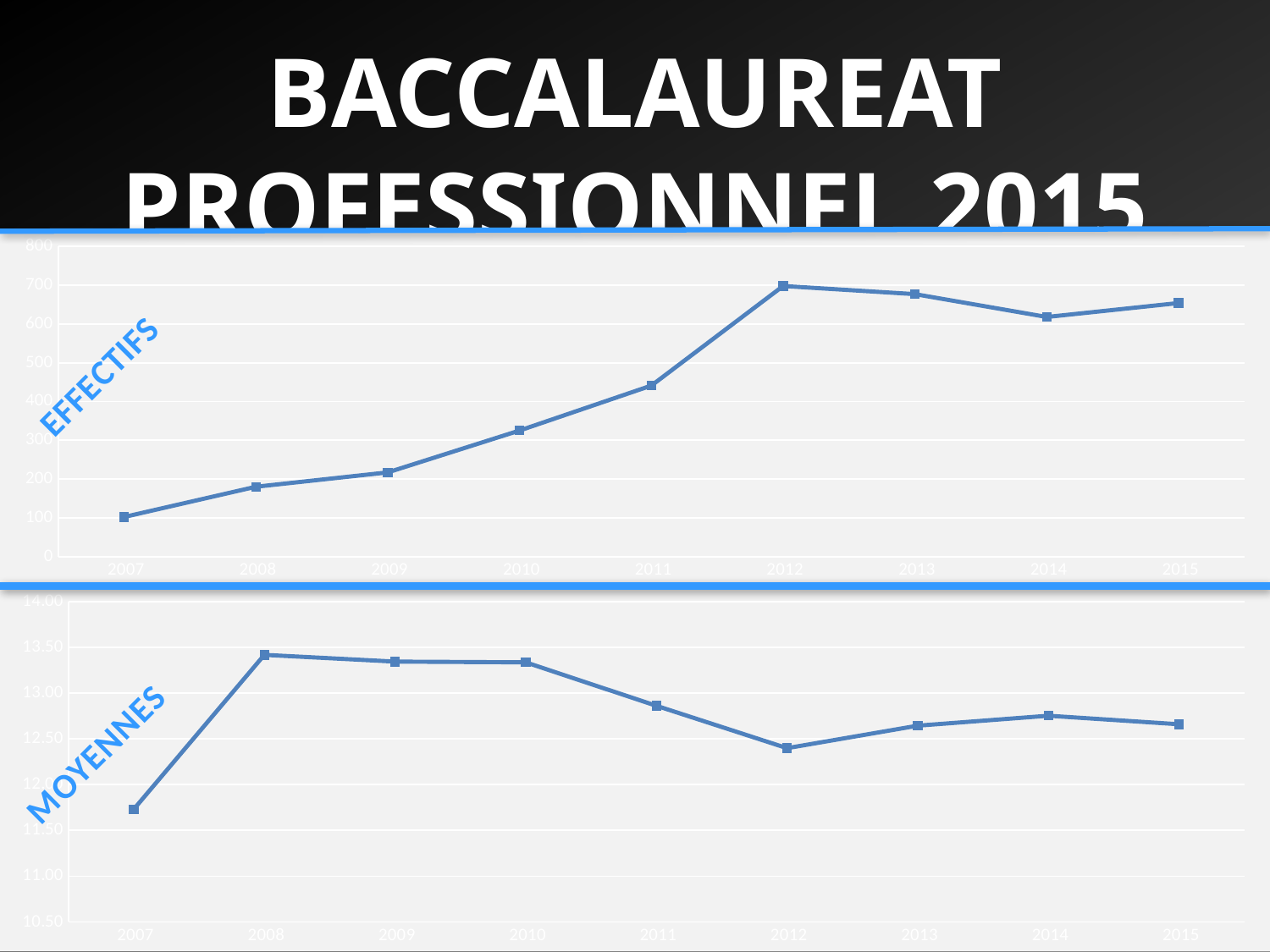
How many years are plotted on the EFFECTIFS chart? 9 On the MOYENNES chart, which year has the lowest value? 2007 On the EFFECTIFS chart, do the values rise or fall from 2007 to 2012? rise On the MOYENNES chart, is the value for 2012 greater or less than 12.50? less On the EFFECTIFS chart, which year has the lowest value? 2007 What kind of chart is the top chart labelled EFFECTIFS? line chart On the EFFECTIFS chart, is the value for 2011 greater or less than 400? greater On the EFFECTIFS chart, which is larger, the value for 2009 or the value for 2010? 2010 On the EFFECTIFS chart, which year has the highest value? 2012 What is the label written beside the bottom chart? MOYENNES On the EFFECTIFS chart, is the value for 2010 greater or less than 400? less On the MOYENNES chart, which is larger, the value for 2011 or the value for 2012? 2011